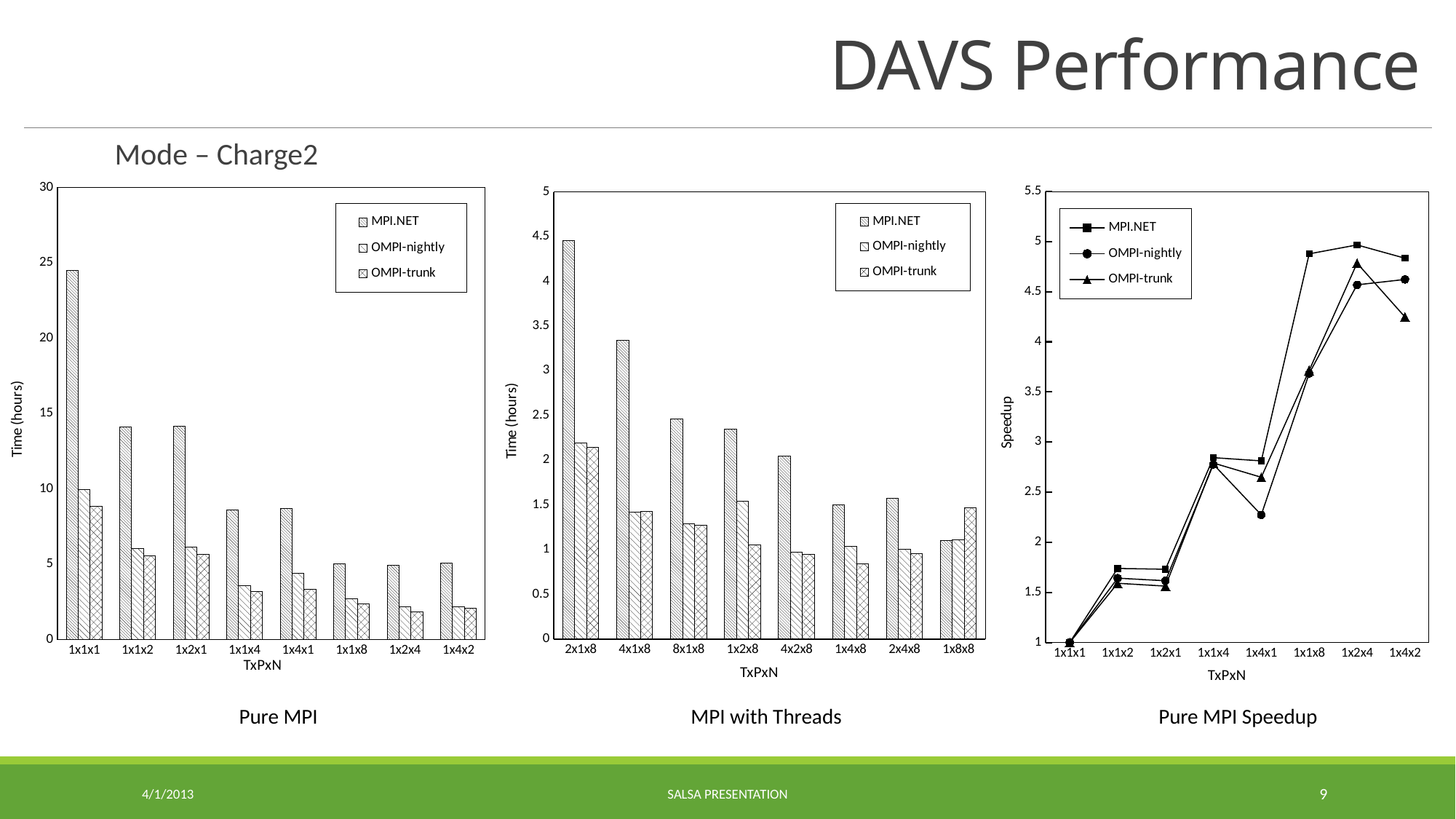
On the Pure MPI chart, how many TxPxN categories are shown on the x axis? 8 On the Pure MPI Speedup chart, for 1x4x2, which is larger: MPI.NET or OMPI-trunk? MPI.NET On the Pure MPI chart, is the OMPI-trunk value for 1x1x1 greater or less than 10? less On the Pure MPI chart, which TxPxN category has the highest MPI.NET time? 1x1x1 On the MPI with Threads chart, for 1x8x8, which is larger: MPI.NET or OMPI-trunk? OMPI-trunk On the Pure MPI chart, is the MPI.NET value for 1x1x1 greater or less than 20? greater On the Pure MPI chart, how many series does the legend list? 3 On the MPI with Threads chart, which TxPxN category has the highest MPI.NET time? 2x1x8 On the MPI with Threads chart, is the MPI.NET value for 2x1x8 greater or less than 4? greater On the Pure MPI Speedup chart, what kind of chart is it? line chart On the Pure MPI chart, what kind of chart is it? bar chart